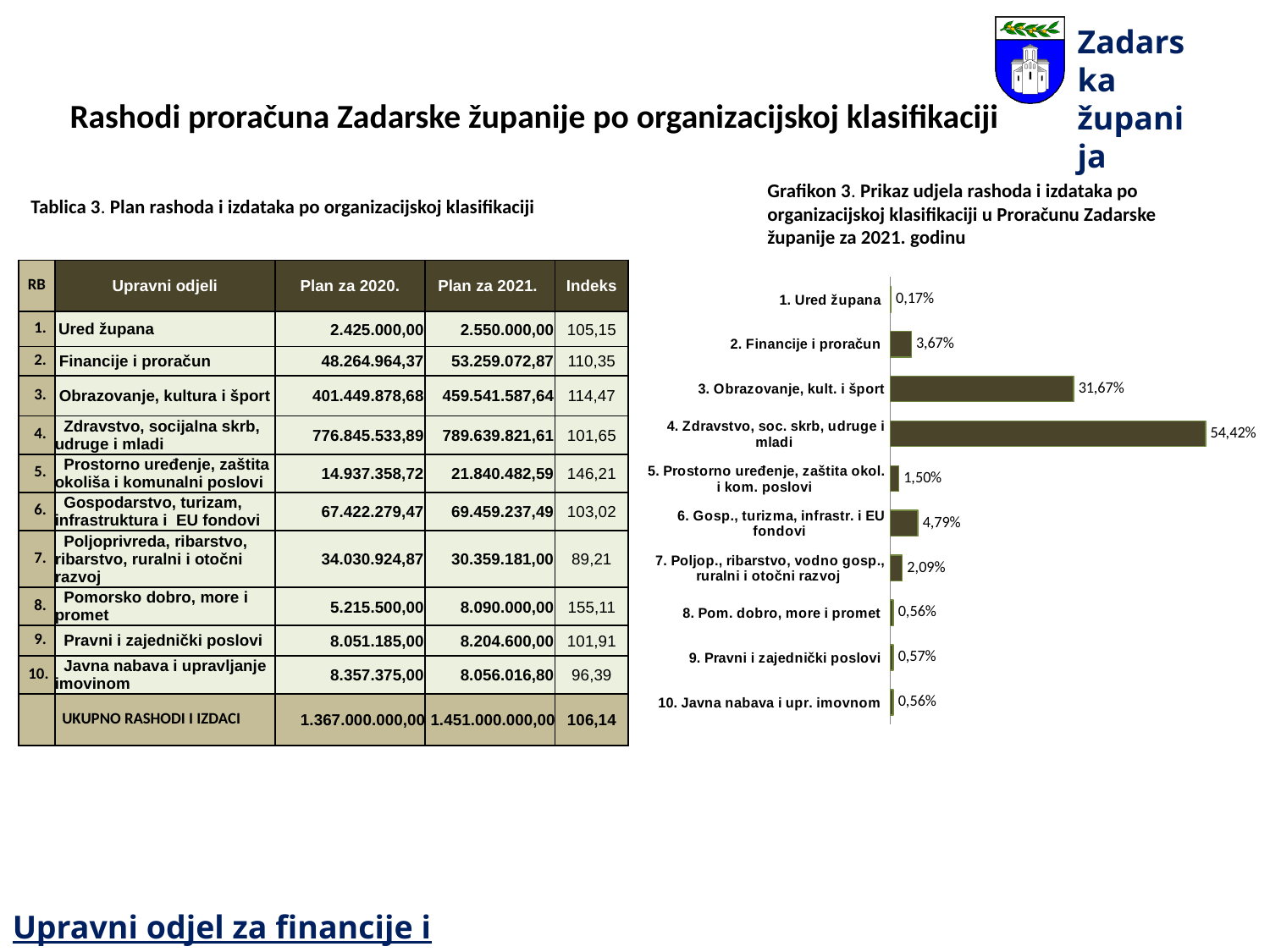
Which is larger: the value for "6. Gosp., turizma, infrastr. i EU fondovi" or for "2. Financije i proračun"? 6. Gosp., turizma, infrastr. i EU fondovi How many categories does the bar chart show? 10 What is the value for "4. Zdravstvo, soc. skrb, udruge i mladi" in the bar chart? 54,42% What is the value for "2. Financije i proračun" in the bar chart? 3,67% What is the title of the chart on the slide? Grafikon 3. Prikaz udjela rashoda i izdataka po organizacijskoj klasifikaciji u Proračunu Zadarske županije za 2021. godinu Which category has the lowest value in the bar chart? 1. Ured župana What is the value for "6. Gosp., turizma, infrastr. i EU fondovi" in the bar chart? 4,79% What is the difference between the values for "4. Zdravstvo, soc. skrb, udruge i mladi" and "3. Obrazovanje, kult. i šport"? 22,75% What is the value for "7. Poljop., ribarstvo, vodno gosp., ruralni i otočni razvoj" in the bar chart? 2,09% What is the value for "3. Obrazovanje, kult. i šport" in the bar chart? 31,67% Which category has the highest value in the bar chart? 4. Zdravstvo, soc. skrb, udruge i mladi What kind of chart is shown on the slide? bar chart